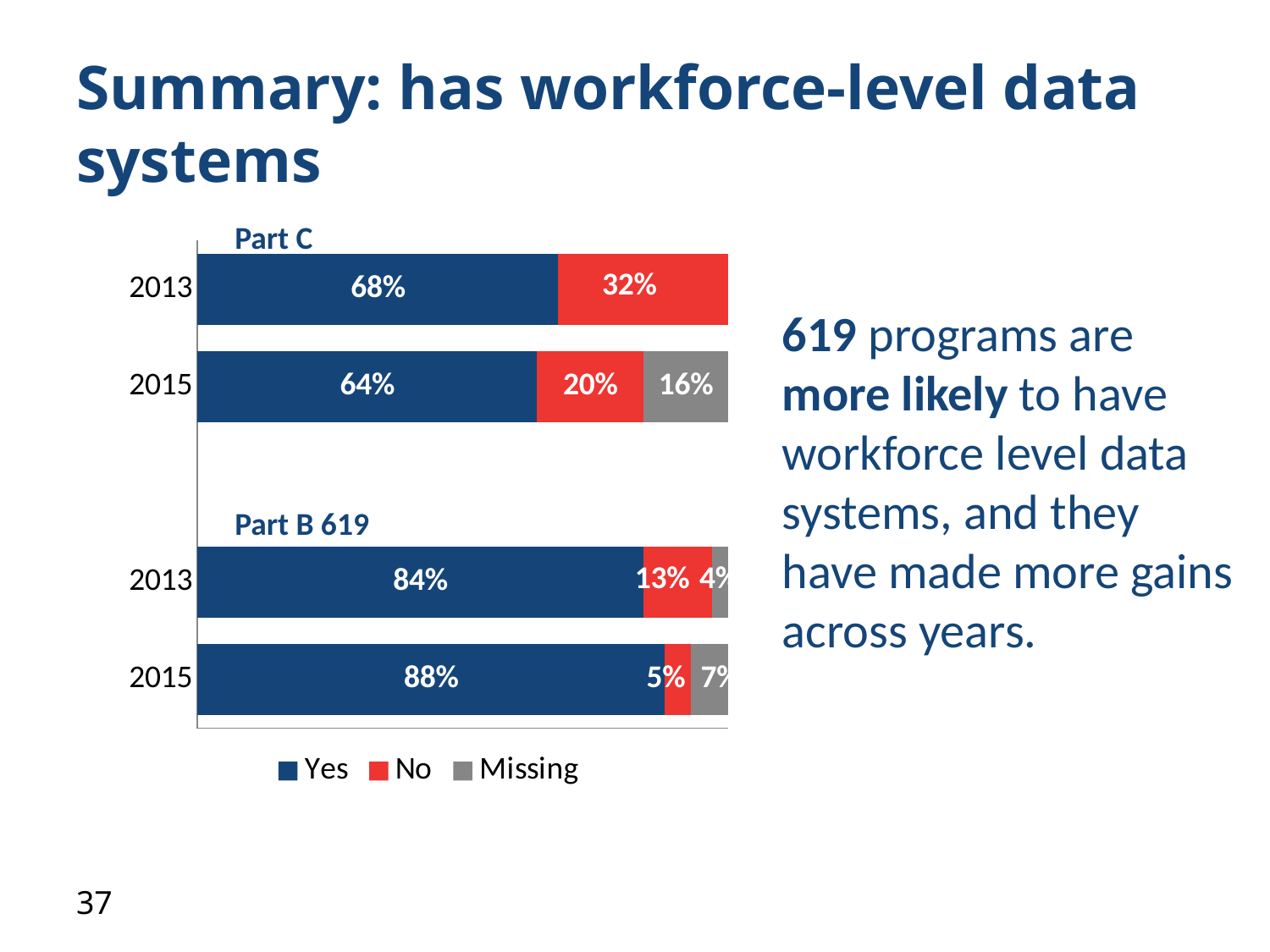
Which bar has the highest 'Yes' value? Part B 619, 2015 What is the 'Yes' value for Part C in 2013? 68% What is the difference between the 'Yes' values for Part B 619 in 2015 and 2013? 4% What is the 'No' value for Part B 619 in 2013? 13% What type of chart is shown on the slide? Stacked bar chart What are the series names listed in the chart legend? Yes, No, Missing How many series does the chart legend list? 3 Which is larger: the 'No' value for Part C in 2013 or the 'No' value for Part C in 2015? Part C 2013 What is the 'Missing' value for Part C in 2015? 16% What is the 'Yes' value for Part B 619 in 2015? 88% What is the 'No' value for Part C in 2015? 20% Which bar has the lowest 'Yes' value? Part C, 2015